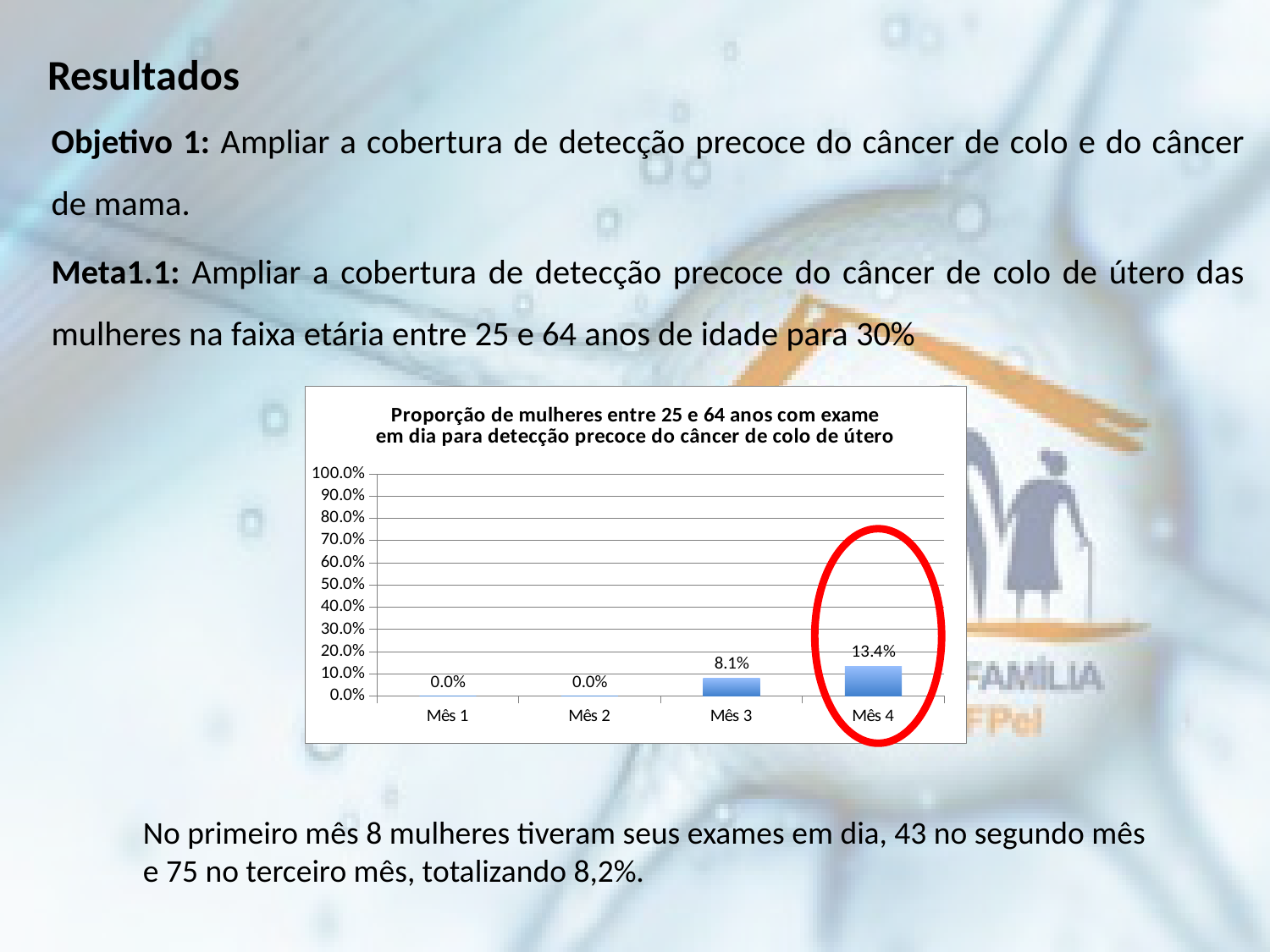
What is the value for Mês 3? 8.1% What is the value for Mês 1? 0.0% What kind of chart is shown on the slide? bar chart Which month has the highest value? Mês 4 What is the value for Mês 4? 13.4% Is the value for Mês 4 greater or less than 20.0%? less How many months are shown on the x axis? 4 What is the title of the chart? Proporção de mulheres entre 25 e 64 anos com exame em dia para detecção precoce do câncer de colo de útero Which is larger, the value for Mês 3 or the value for Mês 4? Mês 4 What is the highest value shown on the y axis? 100.0% What is the difference between the values for Mês 4 and Mês 3? 5.3% Do the values rise or fall from Mês 1 to Mês 4? rise